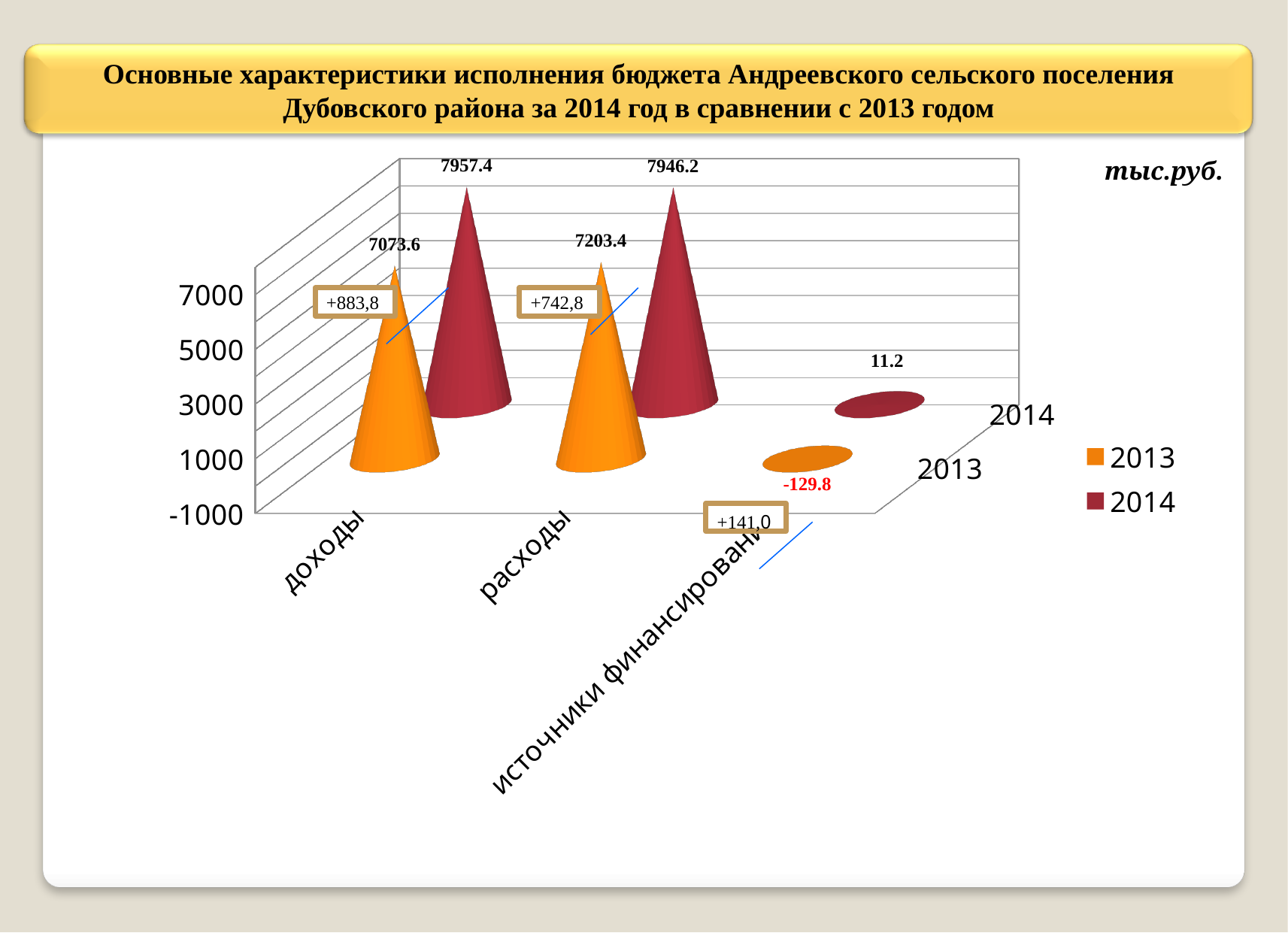
What unit of measurement is indicated on the chart? тыс.руб. Which category has the lowest value in the 2013 series? источники финансирования What is the value for доходы in 2013? 7073.6 How many categories are shown on the x axis? 3 Which category has the highest value in the 2014 series? доходы What is the difference between the 2014 and 2013 values for расходы? 742.8 How many series does the legend list? 2 What is the value for расходы in 2014? 7946.2 What is the value for источники финансирования in 2014? 11.2 Which is larger: the 2013 value for доходы or the 2013 value for расходы? расходы (2013) What is the value for доходы in 2014? 7957.4 What is the value for источники финансирования in 2013? -129.8